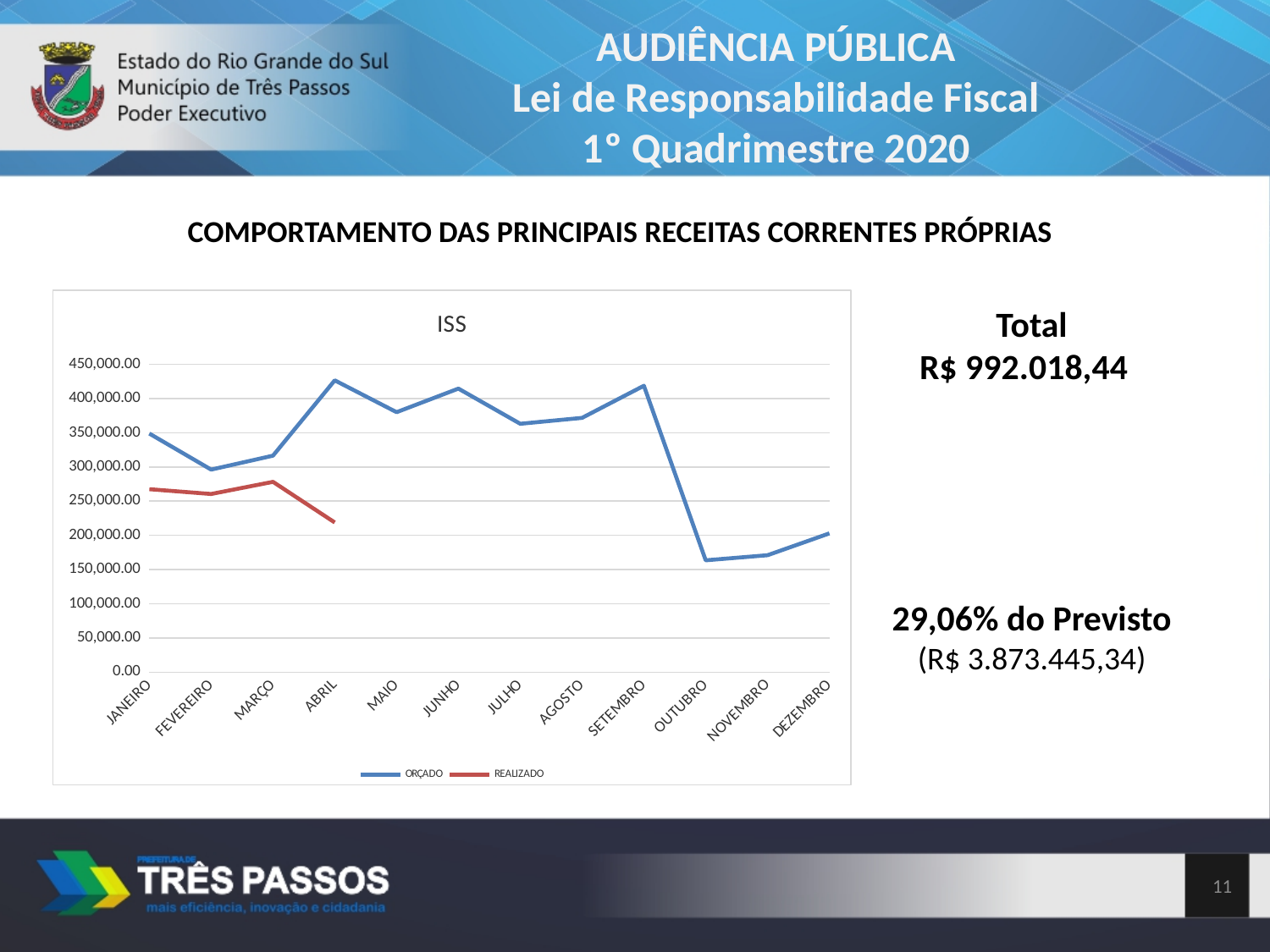
In which month does the REALIZADO series reach its highest value? MARÇO Is the REALIZADO value for MARÇO greater or less than 250,000.00? greater In ABRIL, which series has the larger value, ORÇADO or REALIZADO? ORÇADO What are the two series named in the chart legend? ORÇADO and REALIZADO In which month does the REALIZADO series reach its lowest value? ABRIL Does the ORÇADO series rise or fall from SETEMBRO to OUTUBRO? fall How many months are shown on the x axis of the chart? 12 What is the title of the chart? ISS What kind of chart is shown on the slide? line chart How many series does the chart legend list? 2 Is the ORÇADO value for ABRIL greater or less than 400,000.00? greater Is the ORÇADO value for NOVEMBRO greater or less than 200,000.00? less